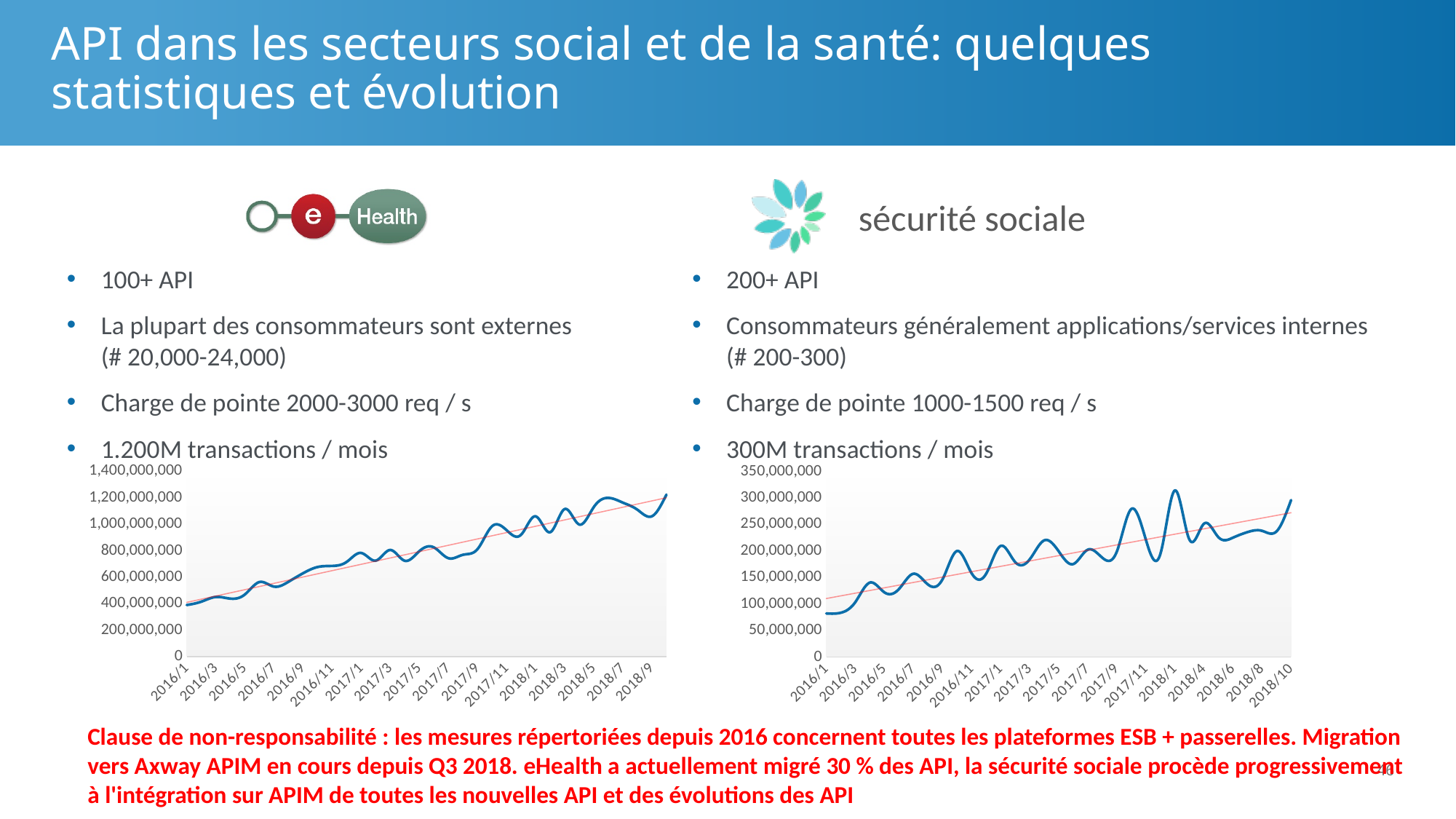
In the left (eHealth) chart, is the value for 2017/1 greater or less than 600,000,000? greater What is the highest value shown on the y axis of the left (eHealth) chart? 1,400,000,000 In the left (eHealth) chart, is the value for 2018/9 greater or less than 1,000,000,000? greater In the right (sécurité sociale) chart, do the values generally rise or fall from 2016/1 to 2018/10? rise In the left (eHealth) chart, is the value for 2016/1 greater or less than 600,000,000? less In the left (eHealth) chart, do the values generally rise or fall from 2016/1 to 2018/9? rise What kind of chart is the left chart under the eHealth section? line chart What kind of chart is the right chart under the sécurité sociale section? line chart What is the highest value shown on the y axis of the right (sécurité sociale) chart? 350,000,000